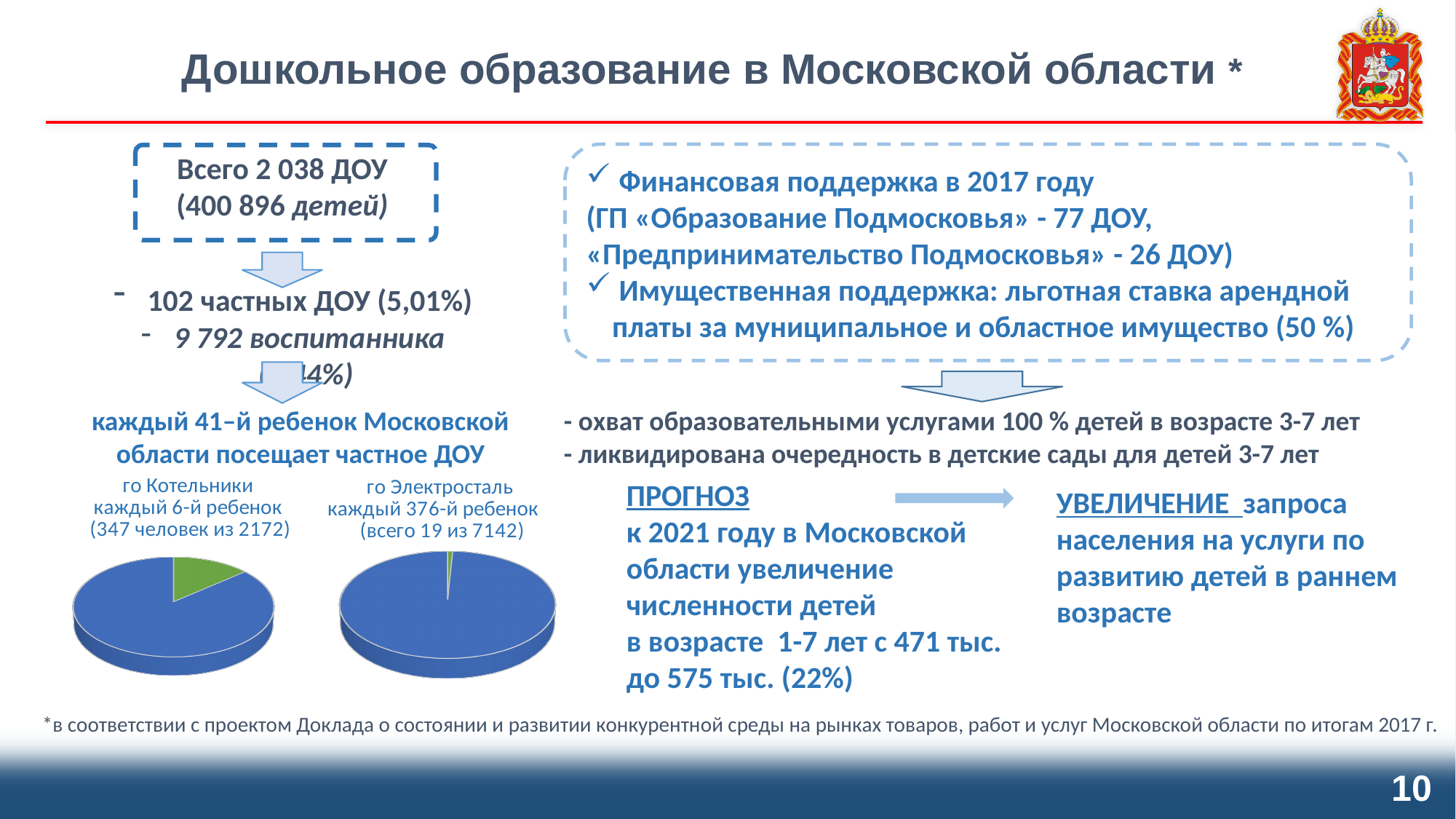
In the го Электросталь chart, how many children are shown attending a private ДОУ? 19 What colour is the largest slice in both pie charts? blue In the го Котельники chart, what is the total number of children out of which 347 attend a private ДОУ? 2172 What kind of chart is used for го Электросталь? pie chart In the го Электросталь chart, what is the total number of children? 7142 How many pie charts are shown on the slide? 2 In the го Котельники chart, how many children (человек) are shown attending a private ДОУ? 347 What kind of chart is used for го Котельники? pie chart According to the го Котельники chart caption, every which child attends a private ДОУ? каждый 6-й ребенок Which pie chart has the larger green slice, го Котельники or го Электросталь? го Котельники How many slices does the го Электросталь pie chart have? 2 How many slices does the го Котельники pie chart have? 2